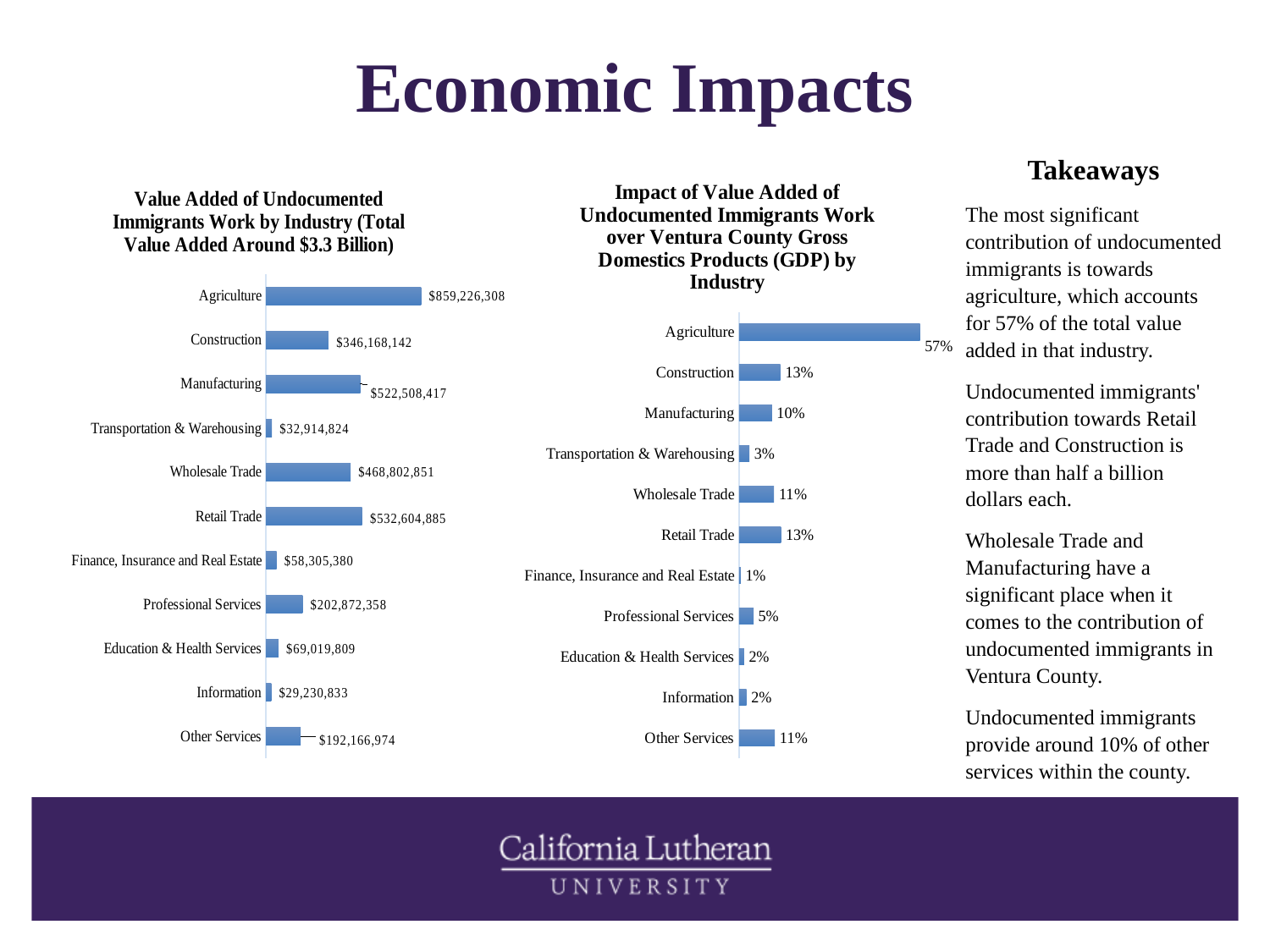
In the left chart (Value Added of Undocumented Immigrants Work by Industry), what is the difference between Construction and Professional Services? $143,295,784 In the left chart (Value Added of Undocumented Immigrants Work by Industry), what is the value for Agriculture? $859,226,308 In the right chart (Impact of Value Added of Undocumented Immigrants Work over Ventura County GDP by Industry), what is the value for Agriculture? 57% In the left chart (Value Added of Undocumented Immigrants Work by Industry), which industry has the highest value? Agriculture In the right chart (Impact of Value Added of Undocumented Immigrants Work over Ventura County GDP by Industry), what is the difference between Construction and Manufacturing? 3% What type of chart is the right chart (Impact of Value Added of Undocumented Immigrants Work over Ventura County GDP by Industry)? Bar chart In the right chart (Impact of Value Added of Undocumented Immigrants Work over Ventura County GDP by Industry), which industry has the lowest value? Finance, Insurance and Real Estate In the left chart (Value Added of Undocumented Immigrants Work by Industry), which industry has the lowest value? Information How many industries are shown in the left chart (Value Added of Undocumented Immigrants Work by Industry)? 11 In the left chart (Value Added of Undocumented Immigrants Work by Industry), what is the value for Retail Trade? $532,604,885 In the right chart (Impact of Value Added of Undocumented Immigrants Work over Ventura County GDP by Industry), what is the value for Wholesale Trade? 11% In the left chart (Value Added of Undocumented Immigrants Work by Industry), which is larger, Wholesale Trade or Manufacturing? Manufacturing